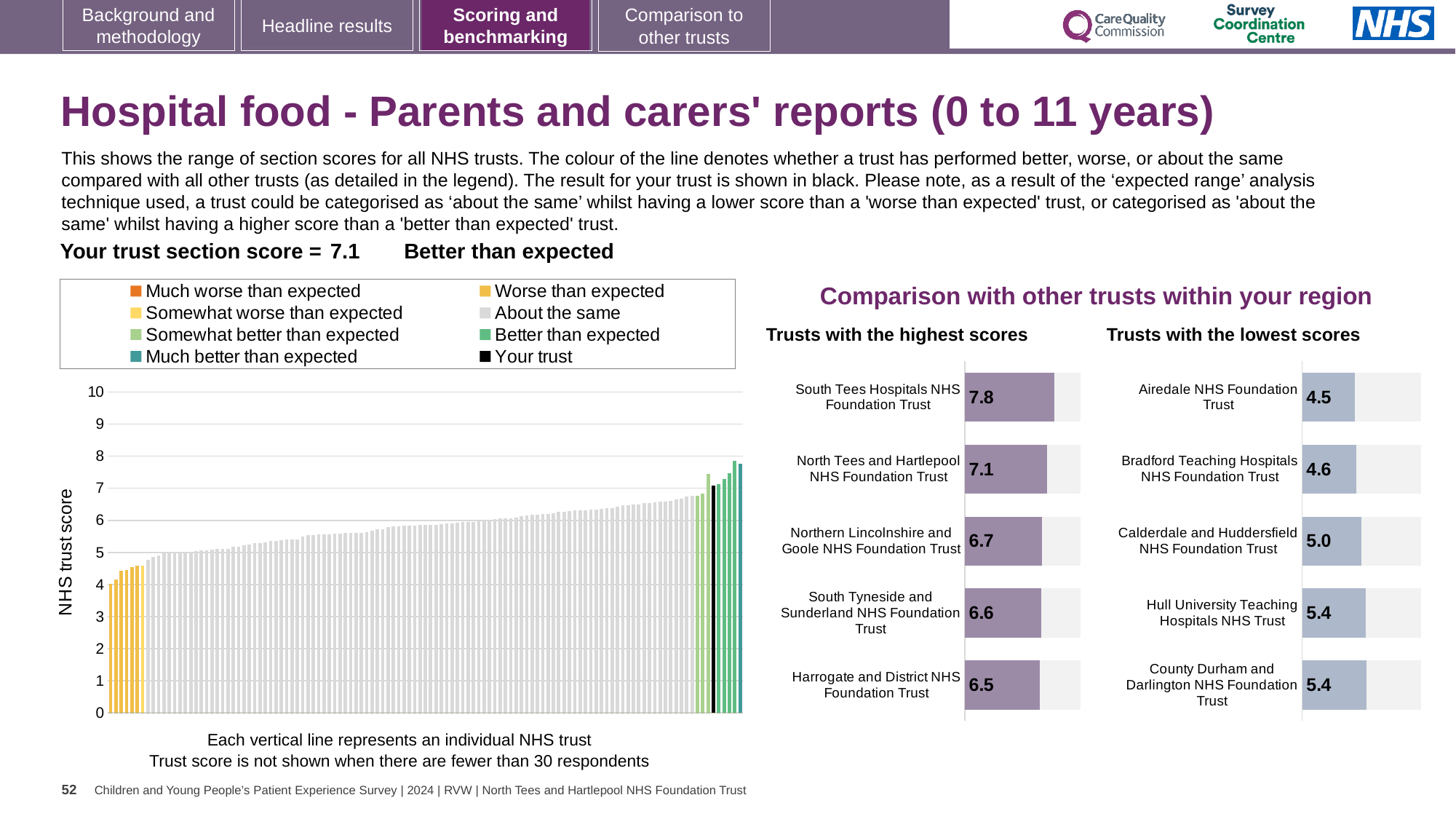
How many entries does the legend of the 'NHS trust score' chart on the left list? 8 In the 'Trusts with the highest scores' chart, what is the score for South Tees Hospitals NHS Foundation Trust? 7.8 In the 'NHS trust score' chart on the left, do the bars rise or fall from left to right? Rise In the 'Trusts with the highest scores' chart, which trust has the highest score? South Tees Hospitals NHS Foundation Trust In the 'Trusts with the lowest scores' chart, what is the score for Calderdale and Huddersfield NHS Foundation Trust? 5.0 What kind of chart is the 'NHS trust score' chart on the left of the slide? Bar chart In the 'NHS trust score' chart on the left, is the value of the leftmost (lowest) bar greater or less than 5? less In the 'Trusts with the lowest scores' chart, which has the larger score: Bradford Teaching Hospitals NHS Foundation Trust or Calderdale and Huddersfield NHS Foundation Trust? Calderdale and Huddersfield NHS Foundation Trust In the 'Trusts with the highest scores' chart, what is the score for Harrogate and District NHS Foundation Trust? 6.5 How many trusts are shown in the 'Trusts with the lowest scores' chart? 5 In the 'Trusts with the lowest scores' chart, which trust has the lowest score? Airedale NHS Foundation Trust In the 'Trusts with the highest scores' chart, what is the difference between the scores of South Tees Hospitals NHS Foundation Trust and Harrogate and District NHS Foundation Trust? 1.3